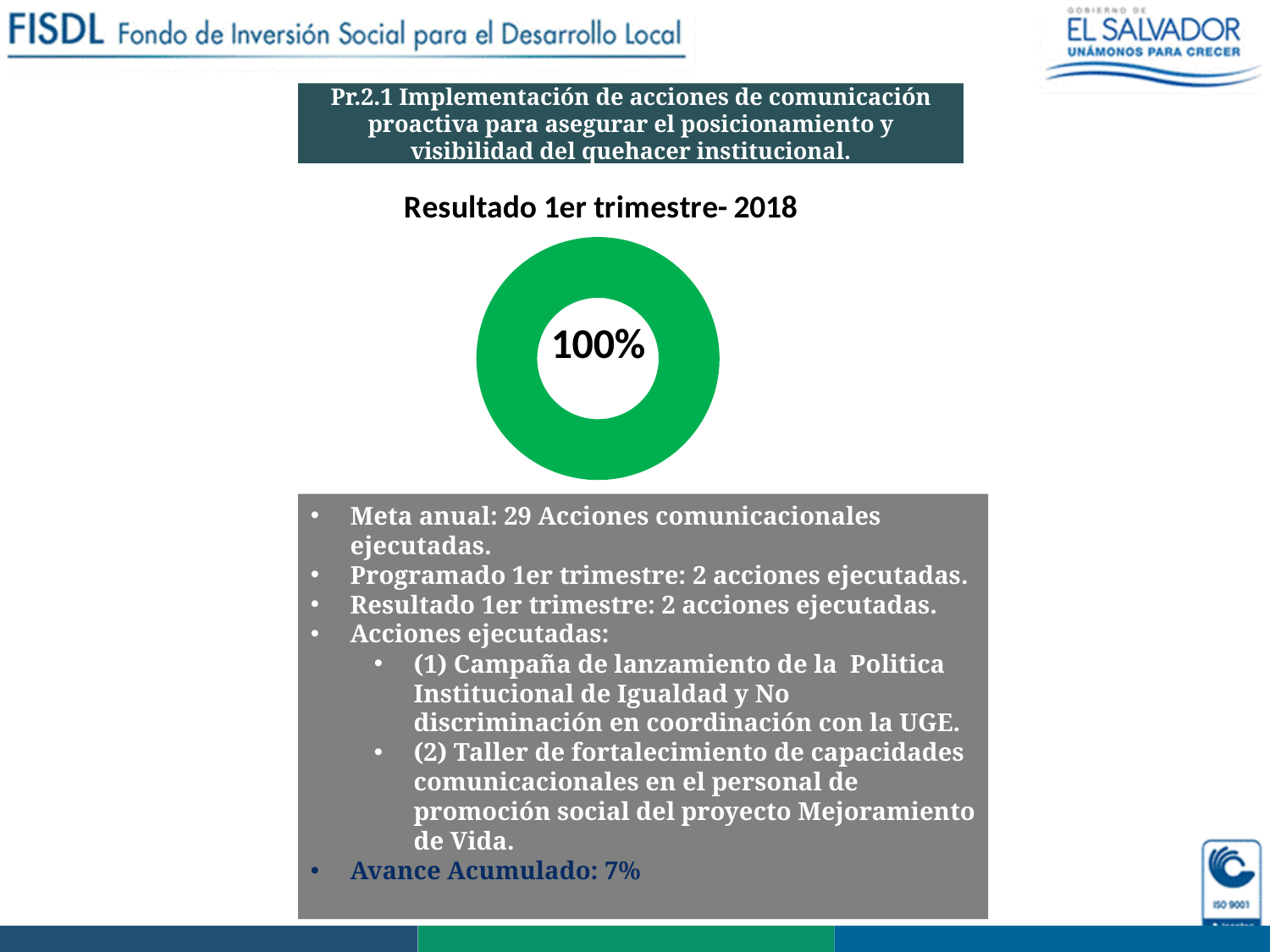
Is the value shown in the doughnut chart greater or less than 50%? greater What share of the doughnut chart does the single green slice occupy? 100% What is the title shown above the doughnut chart? Resultado 1er trimestre- 2018 What kind of chart is shown on the slide? doughnut chart What colour is the ring of the doughnut chart? green What value is printed in the centre of the doughnut chart? 100% How many slices does the doughnut chart show? 1